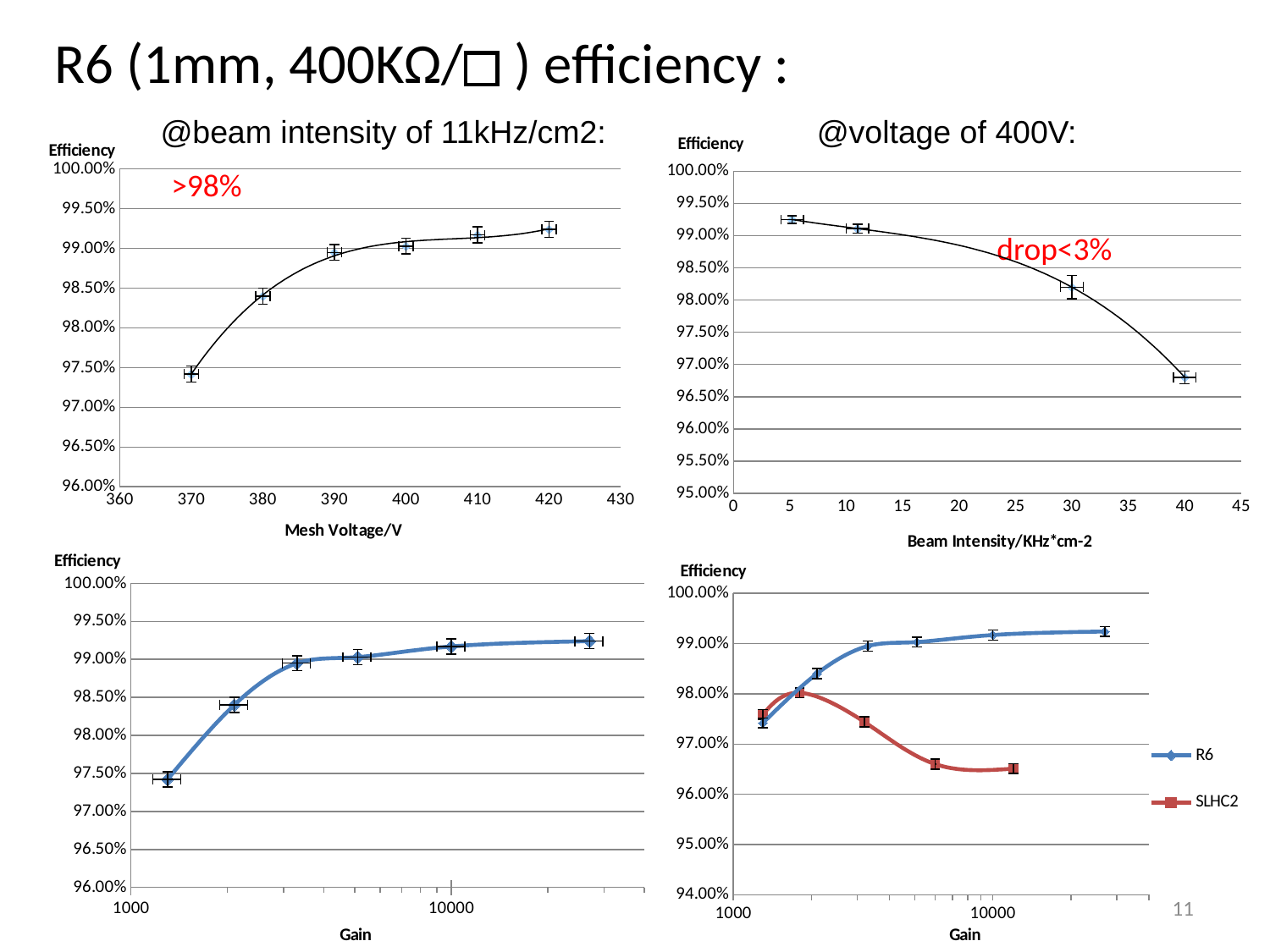
What red annotation is written on the top-right chart (efficiency vs Beam Intensity)? drop<3% In the top-right chart (efficiency vs Beam Intensity), does efficiency rise or fall as beam intensity increases? fall In the top-left chart (efficiency vs Mesh Voltage), how many data points are plotted? 6 In the bottom-right chart (efficiency vs Gain with legend), how many series does the legend list? 2 In the top-right chart (efficiency vs Beam Intensity), is the efficiency at a beam intensity of 40 greater or less than 97.00%? less In the top-right chart (efficiency vs Beam Intensity), how many data points are plotted? 4 In the top-left chart (efficiency vs Mesh Voltage), is the efficiency at 370 V greater or less than 98.00%? less In the bottom-right chart (efficiency vs Gain with legend), which series has the higher efficiency at a gain of 10000, R6 or SLHC2? R6 In the top-left chart (efficiency vs Mesh Voltage), does efficiency rise or fall as mesh voltage increases? rise In the top-right chart (efficiency vs Beam Intensity), at which beam intensity is the efficiency lowest? 40 In the bottom-right chart (efficiency vs Gain with legend), is the SLHC2 efficiency at a gain of 10000 greater or less than 97.00%? less In the top-left chart (efficiency vs Mesh Voltage), at which mesh voltage is the efficiency lowest? 370